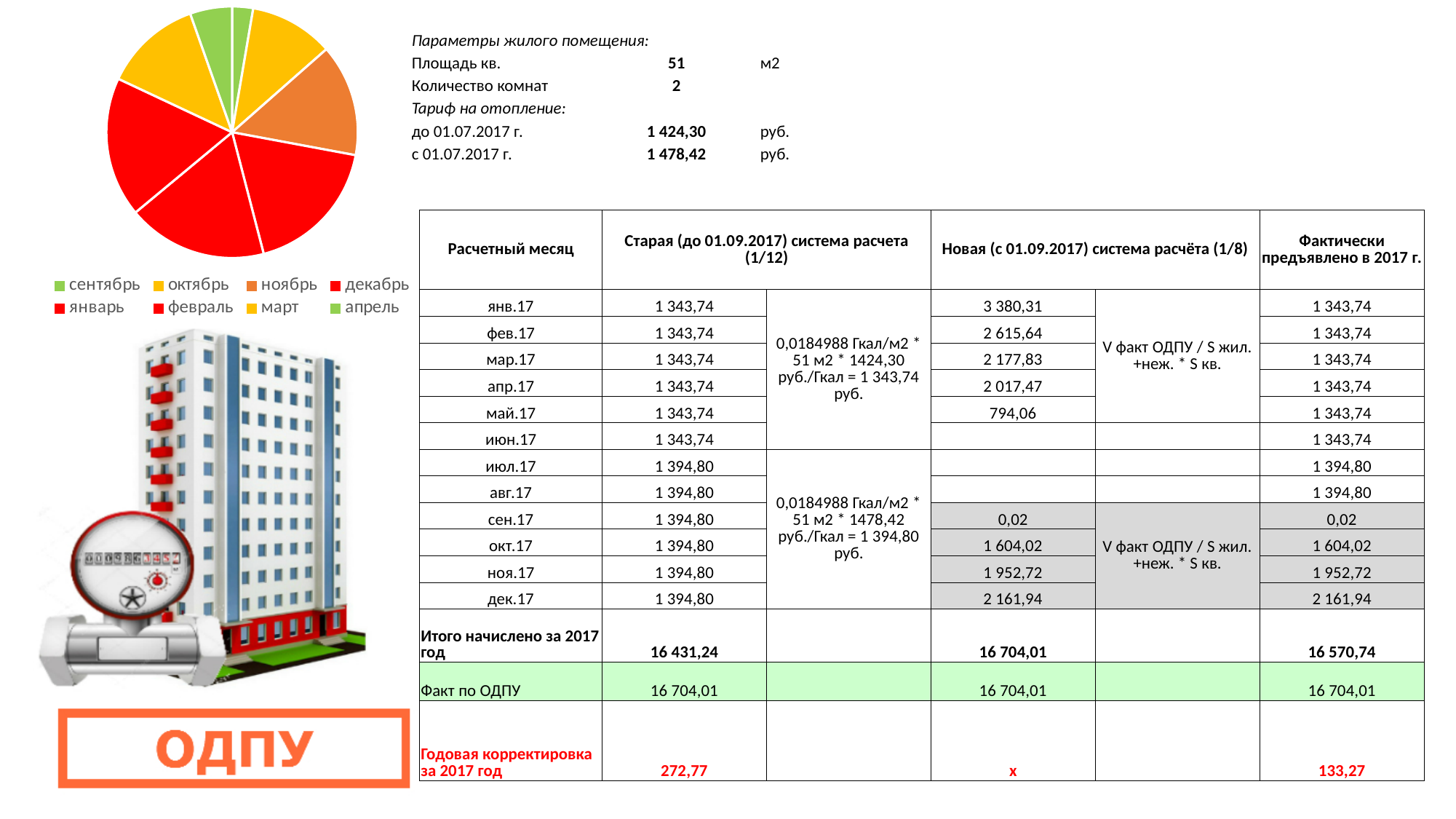
What kind of chart is shown on the left of the slide? pie chart Which legend entry in the pie chart is shown in orange? ноябрь How many entries does the pie chart's legend list? 8 Which month has the smallest slice in the pie chart? сентябрь How many slices does the pie chart have? 8 In the pie chart, which slice is larger: сентябрь or октябрь? октябрь What colour is the сентябрь slice in the pie chart? green In the pie chart, which slice is larger: апрель or декабрь? декабрь In the pie chart, which slice is larger: сентябрь or ноябрь? ноябрь